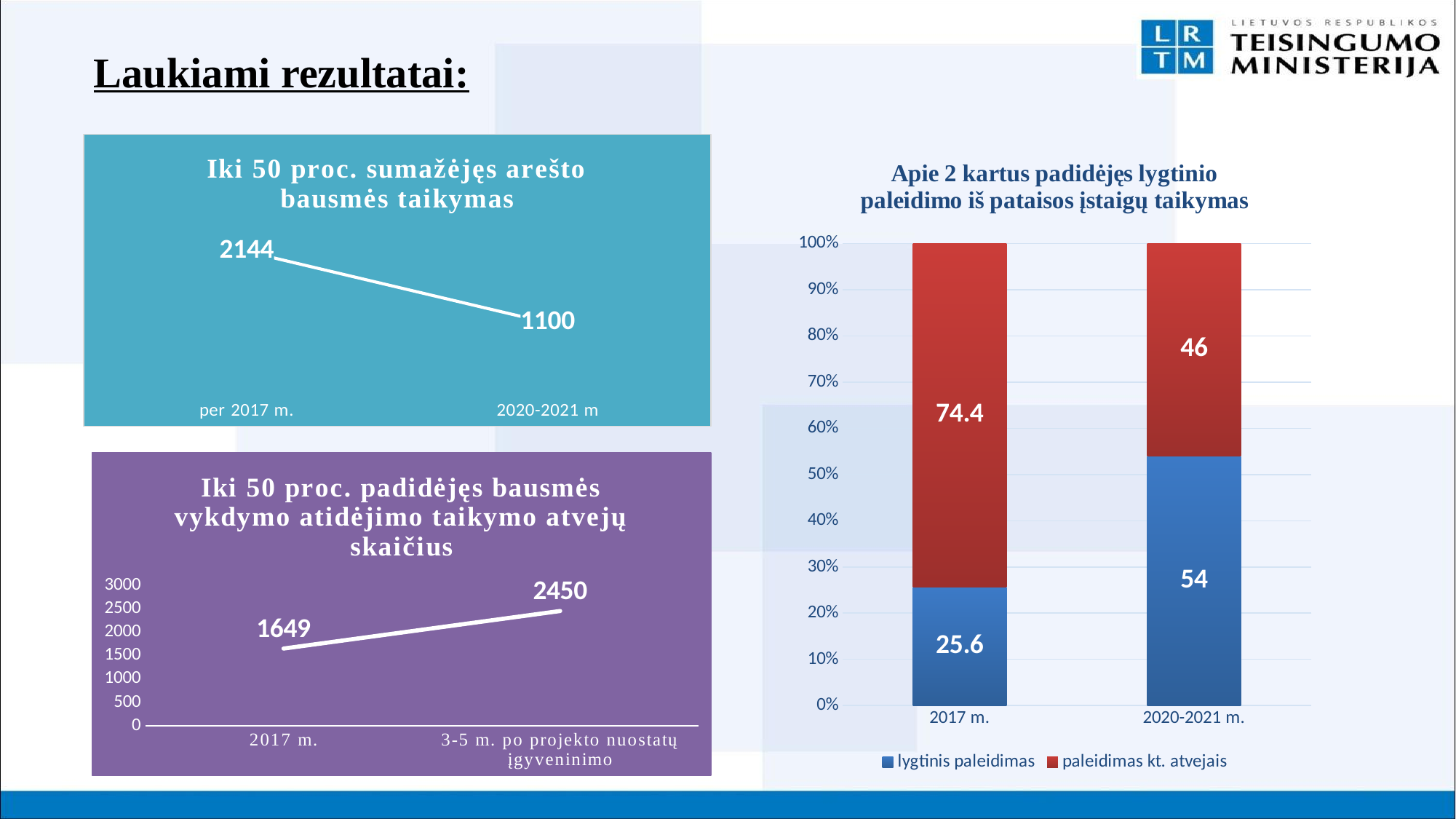
In the top-left chart titled "Iki 50 proc. sumažėjęs arešto bausmės taikymas", what is the difference between the 2017 value and the 2020-2021 value? 1044 In the bottom-left chart titled "Iki 50 proc. padidėjęs bausmės vykdymo atidėjimo taikymo atvejų skaičius", what is the value for "2017 m."? 1649 In the top-left chart titled "Iki 50 proc. sumažėjęs arešto bausmės taikymas", what is the value for "2020-2021 m"? 1100 In the right-hand chart titled "Apie 2 kartus padidėjęs lygtinio paleidimo iš pataisos įstaigų taikymas", which is larger: "lygtinis paleidimas" in 2017 m. or in 2020-2021 m.? 2020-2021 m. In the bottom-left chart titled "Iki 50 proc. padidėjęs bausmės vykdymo atidėjimo taikymo atvejų skaičius", what kind of chart is it? line chart In the right-hand chart titled "Apie 2 kartus padidėjęs lygtinio paleidimo iš pataisos įstaigų taikymas", how many series does the legend list? 2 In the top-left chart titled "Iki 50 proc. sumažėjęs arešto bausmės taikymas", do the values rise or fall from left to right? fall In the bottom-left chart titled "Iki 50 proc. padidėjęs bausmės vykdymo atidėjimo taikymo atvejų skaičius", what is the value for "3-5 m. po projekto nuostatų įgyveninimo"? 2450 In the bottom-left chart titled "Iki 50 proc. padidėjęs bausmės vykdymo atidėjimo taikymo atvejų skaičius", do the values rise or fall from left to right? rise In the right-hand chart titled "Apie 2 kartus padidėjęs lygtinio paleidimo iš pataisos įstaigų taikymas", what is the value of "lygtinis paleidimas" for 2017 m.? 25.6 In the right-hand chart titled "Apie 2 kartus padidėjęs lygtinio paleidimo iš pataisos įstaigų taikymas", what is the value of "paleidimas kt. atvejais" for 2020-2021 m.? 46 In the top-left chart titled "Iki 50 proc. sumažėjęs arešto bausmės taikymas", what is the value for "per 2017 m."? 2144